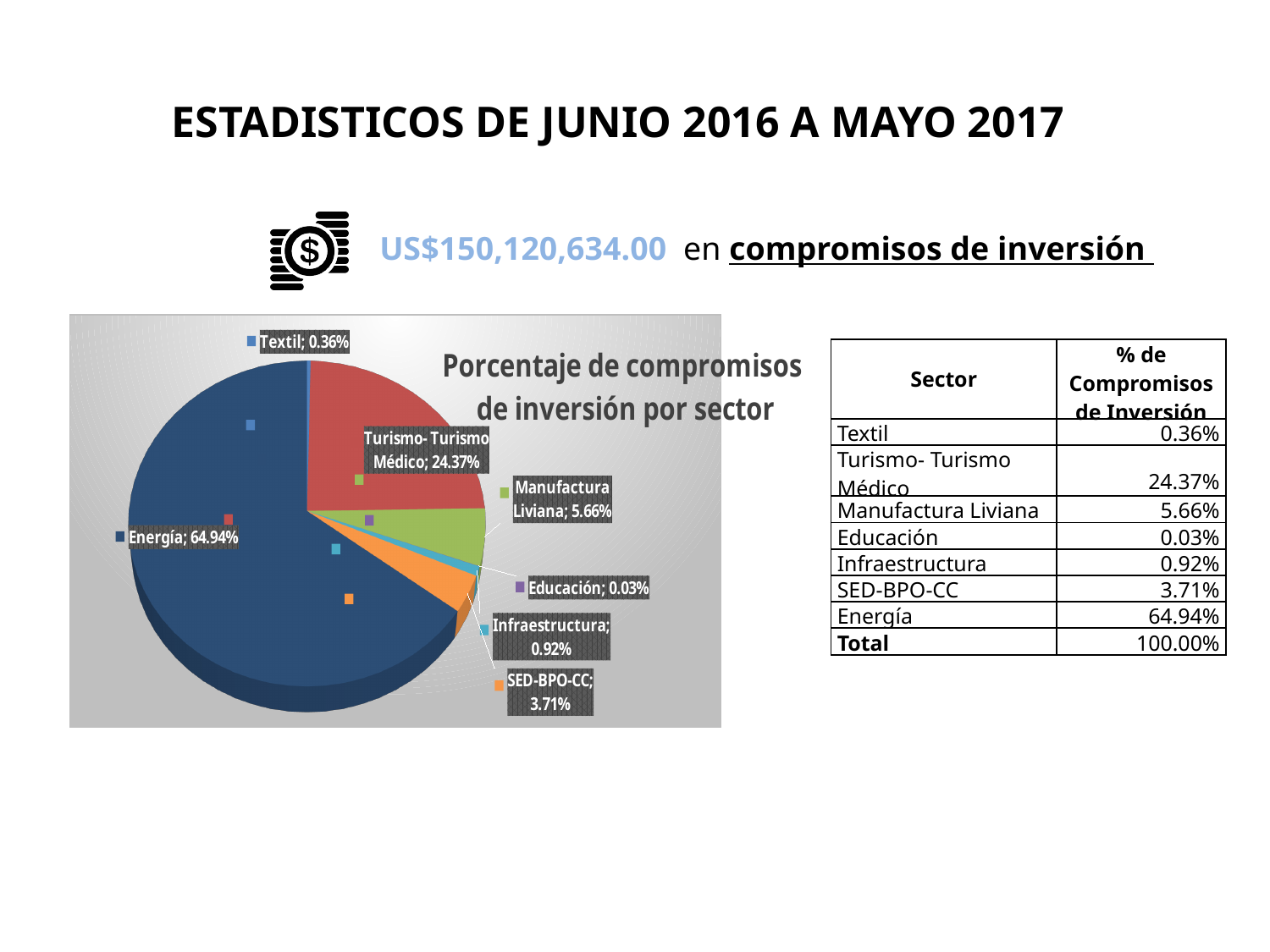
What is the difference in percentage points between Manufactura Liviana and SED-BPO-CC in the pie chart? 1.95 Which sector has the largest slice in the pie chart? Energía What percentage does the Energía slice represent in the pie chart? 64.94% How many sectors are shown in the pie chart? 7 What is the difference in percentage points between Energía and Turismo- Turismo Médico in the pie chart? 40.57 What is the value shown for Turismo- Turismo Médico in the pie chart? 24.37% What is the value shown for SED-BPO-CC in the pie chart? 3.71% What is the title of the pie chart? Porcentaje de compromisos de inversión por sector What is the value shown for Manufactura Liviana in the pie chart? 5.66% Which sector has the smallest slice in the pie chart? Educación What kind of chart is shown on the slide? Pie chart Which is larger in the pie chart, Infraestructura or Textil? Infraestructura